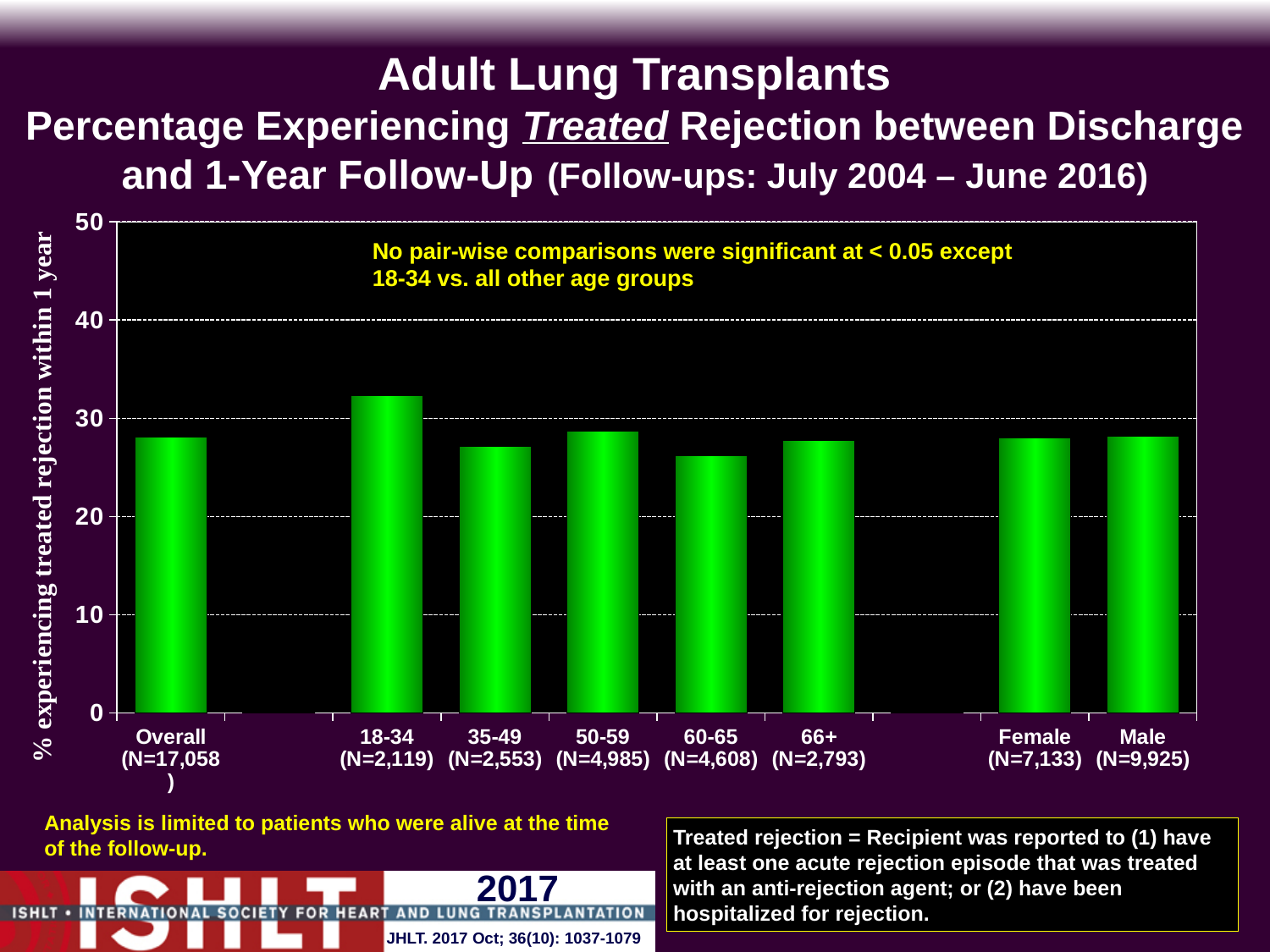
Is the value for Overall greater or less than 30? less Is the value for the 18-34 age group greater or less than 30? greater How many bars (categories) are plotted in the chart? 8 Which category has the highest percentage experiencing treated rejection within 1 year? 18-34 Is the value for the 18-34 age group greater or less than 40? less Which is larger, the value for the 18-34 age group or the value for Overall? 18-34 What kind of chart is shown on the slide? bar chart What is the sample size (N) shown for the Overall category? N=17,058 Which is larger, the value for the 18-34 age group or the value for the 60-65 age group? 18-34 According to the annotation on the chart, which age group's pair-wise comparisons were significant at < 0.05? 18-34 vs. all other age groups